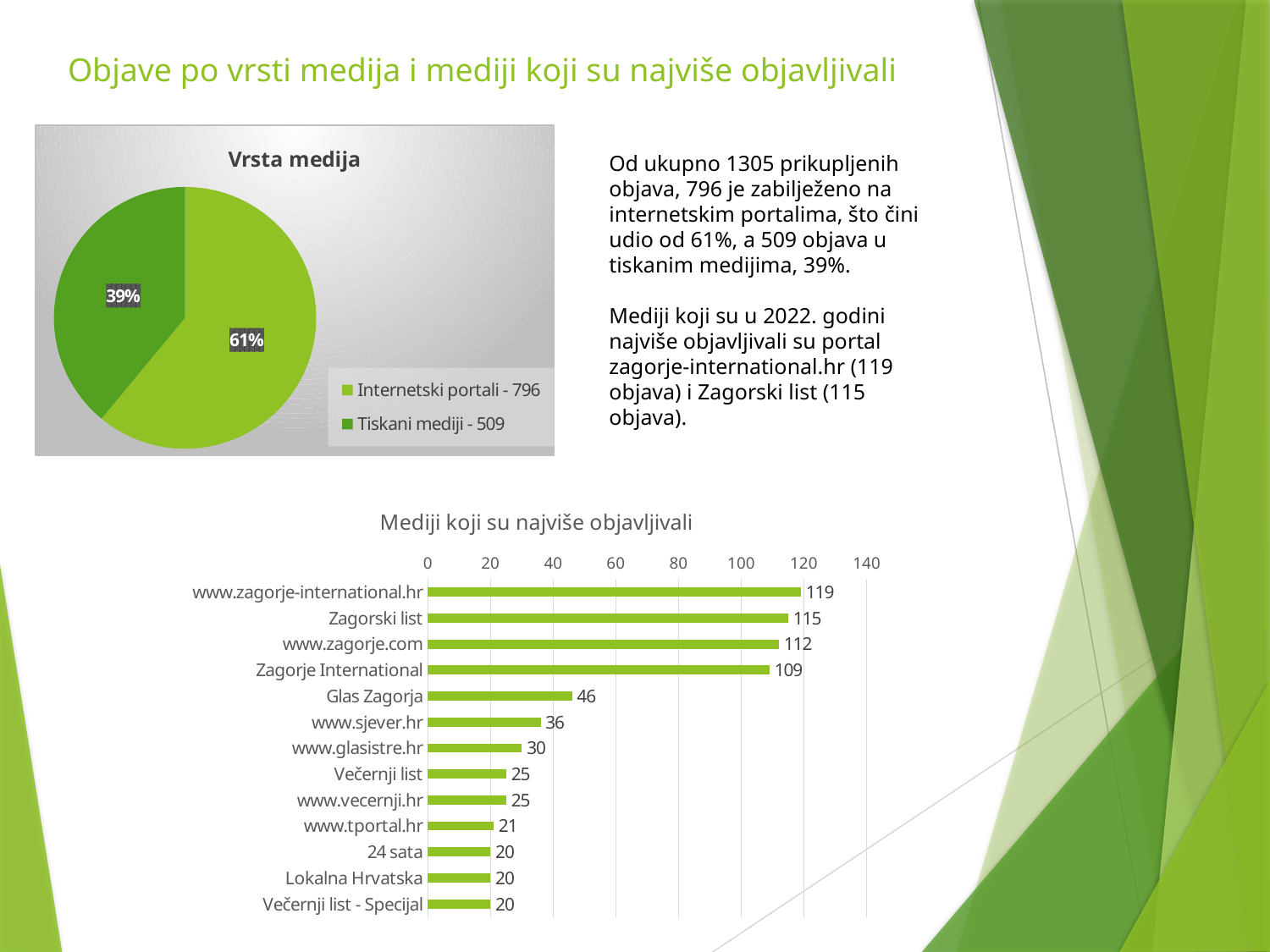
In the 'Mediji koji su najviše objavljivali' chart, is the value for www.zagorje.com greater or less than 100? greater In the 'Mediji koji su najviše objavljivali' chart, what is the value for Zagorski list? 115 In the 'Vrsta medija' chart, how many entries does the legend list? 2 In the 'Mediji koji su najviše objavljivali' chart, what is the value for Glas Zagorja? 46 In the 'Mediji koji su najviše objavljivali' chart, which is larger, www.sjever.hr or www.glasistre.hr? www.sjever.hr What kind of chart is 'Mediji koji su najviše objavljivali'? Bar chart In the 'Vrsta medija' chart, what share of the pie is Internetski portali? 61% In the 'Mediji koji su najviše objavljivali' chart, how many categories are shown? 13 In the 'Vrsta medija' chart, what share of the pie is Tiskani mediji? 39% What kind of chart is 'Vrsta medija'? Pie chart In the 'Mediji koji su najviše objavljivali' chart, which category has the highest value? www.zagorje-international.hr In the 'Mediji koji su najviše objavljivali' chart, what is the difference between www.zagorje-international.hr and Zagorje International? 10